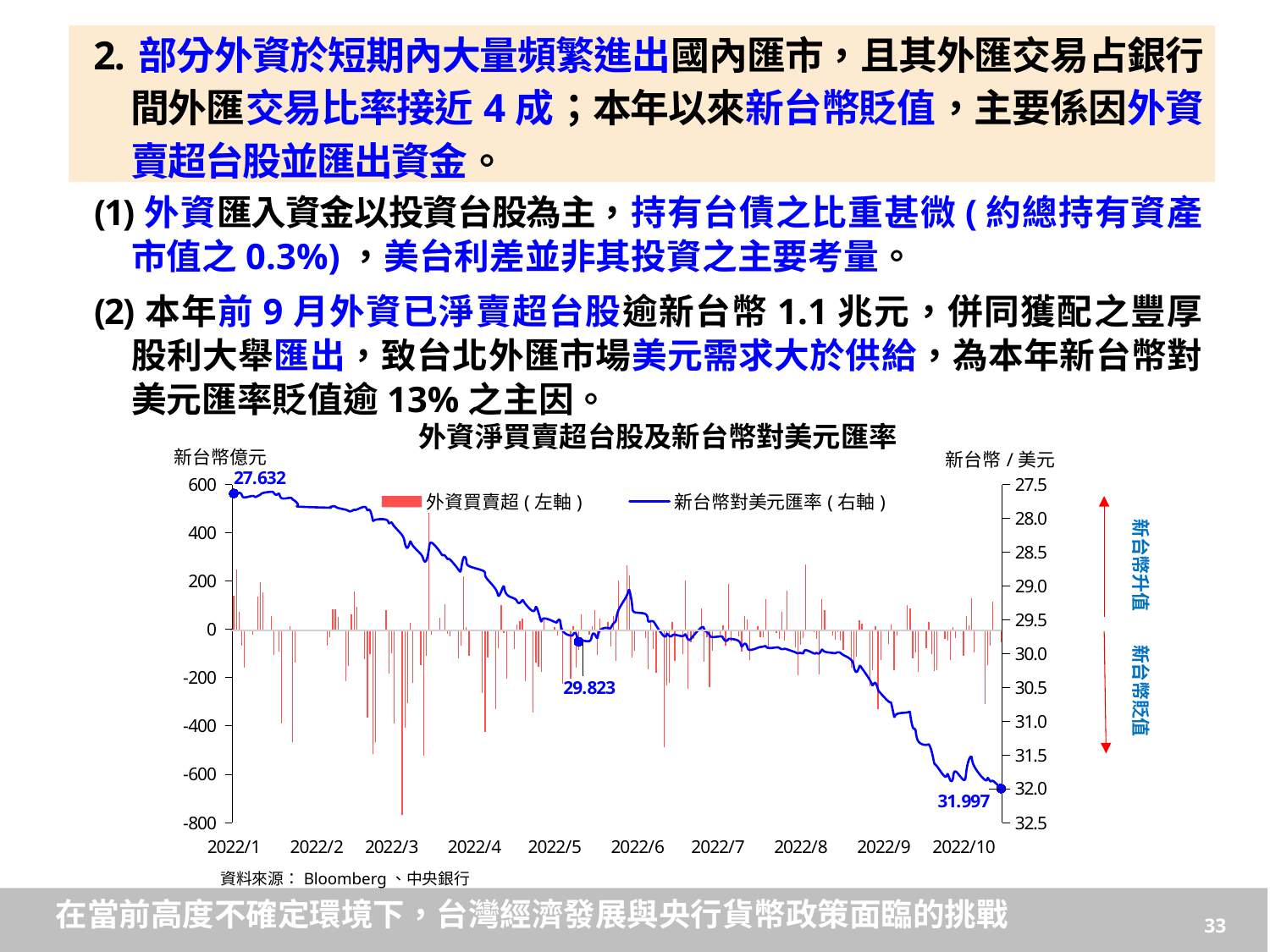
What kind of chart is shown on the slide? Combination bar and line chart Does the numeric value of the 新台幣對美元匯率 line rise or fall from 2022/1 to 2022/10? Rises What is the title of the chart on the slide? 外資淨買賣超台股及新台幣對美元匯率 How many series does the chart's legend list? 2 What is the labelled value of the 新台幣對美元匯率 line at the end of the series in 2022/10? 31.997 How many month labels are shown on the x axis? 10 What is the labelled value of the 新台幣對美元匯率 line at the start of 2022/1? 27.632 What is the difference between the labelled exchange rate at the end (31.997) and at the start (27.632)? 4.365 What is the labelled value of the 新台幣對美元匯率 line in May 2022? 29.823 Is the labelled exchange rate value at the end of 2022/10 greater or less than 31.5? greater Which labelled exchange rate value is larger: the one at the start of 2022/1 or the one at the end in 2022/10? The one at the end in 2022/10 (31.997) What are the two entries in the chart's legend? 外資買賣超(左軸) and 新台幣對美元匯率(右軸)